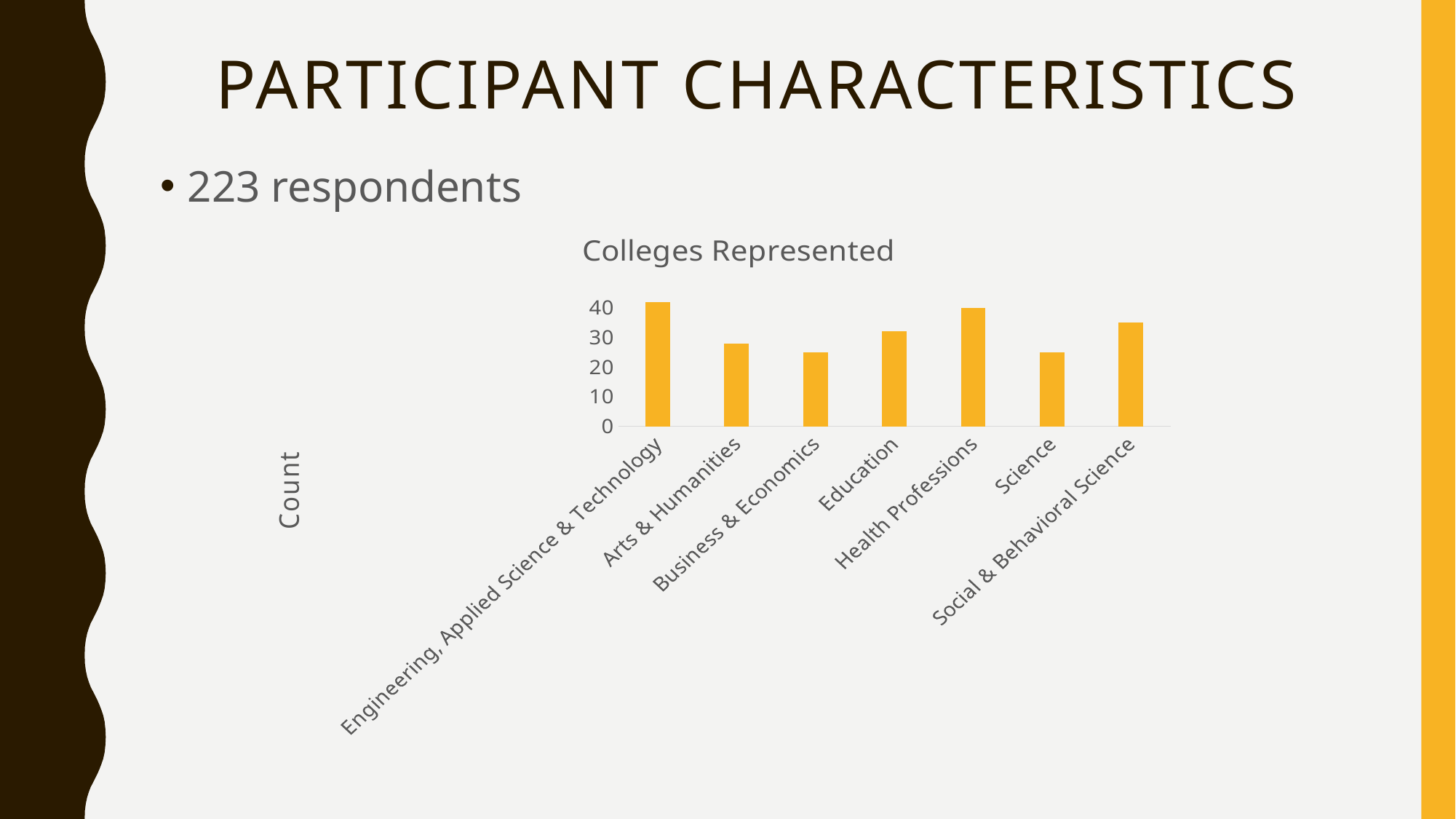
Is the value for Engineering, Applied Science & Technology greater or less than 40? greater Is the value for Arts & Humanities greater or less than 30? less Is the value for Science greater or less than 30? less What is the label on the vertical axis of the chart? Count Which college has the highest count? Engineering, Applied Science & Technology What is the title of the chart? Colleges Represented How many colleges are shown in the chart? 7 Which has a higher count, Health Professions or Education? Health Professions What type of chart is shown on the slide? bar chart Which has a higher count, Social & Behavioral Science or Arts & Humanities? Social & Behavioral Science